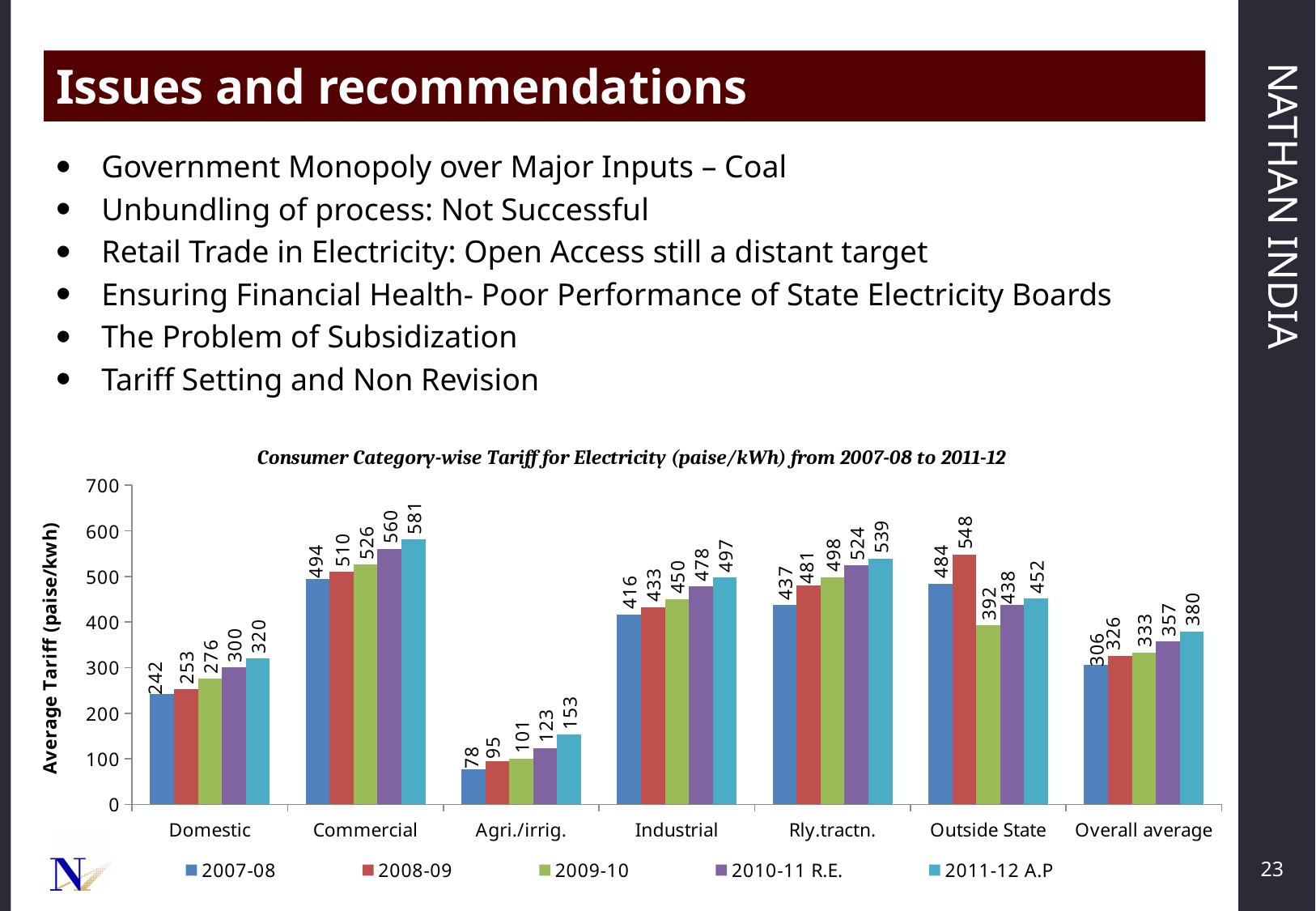
What is the tariff for Agri./irrig. in 2007-08? 78 What is the y-axis label of the chart? Average Tariff (paise/kwh) What is the tariff for Commercial in 2011-12 A.P? 581 What is the difference between the Industrial tariff in 2011-12 A.P and in 2007-08? 81 How many consumer categories are shown on the x axis? 7 Which is larger, the Outside State tariff in 2008-09 or the Rly.tractn. tariff in 2008-09? Outside State What is the tariff for Outside State in 2009-10? 392 Which consumer category has the highest tariff in 2011-12 A.P? Commercial Does the Domestic tariff rise or fall from 2007-08 to 2011-12 A.P? Rise How many series does the legend list? 5 What kind of chart is shown on the slide? Bar chart Which consumer category has the lowest tariff in 2007-08? Agri./irrig.